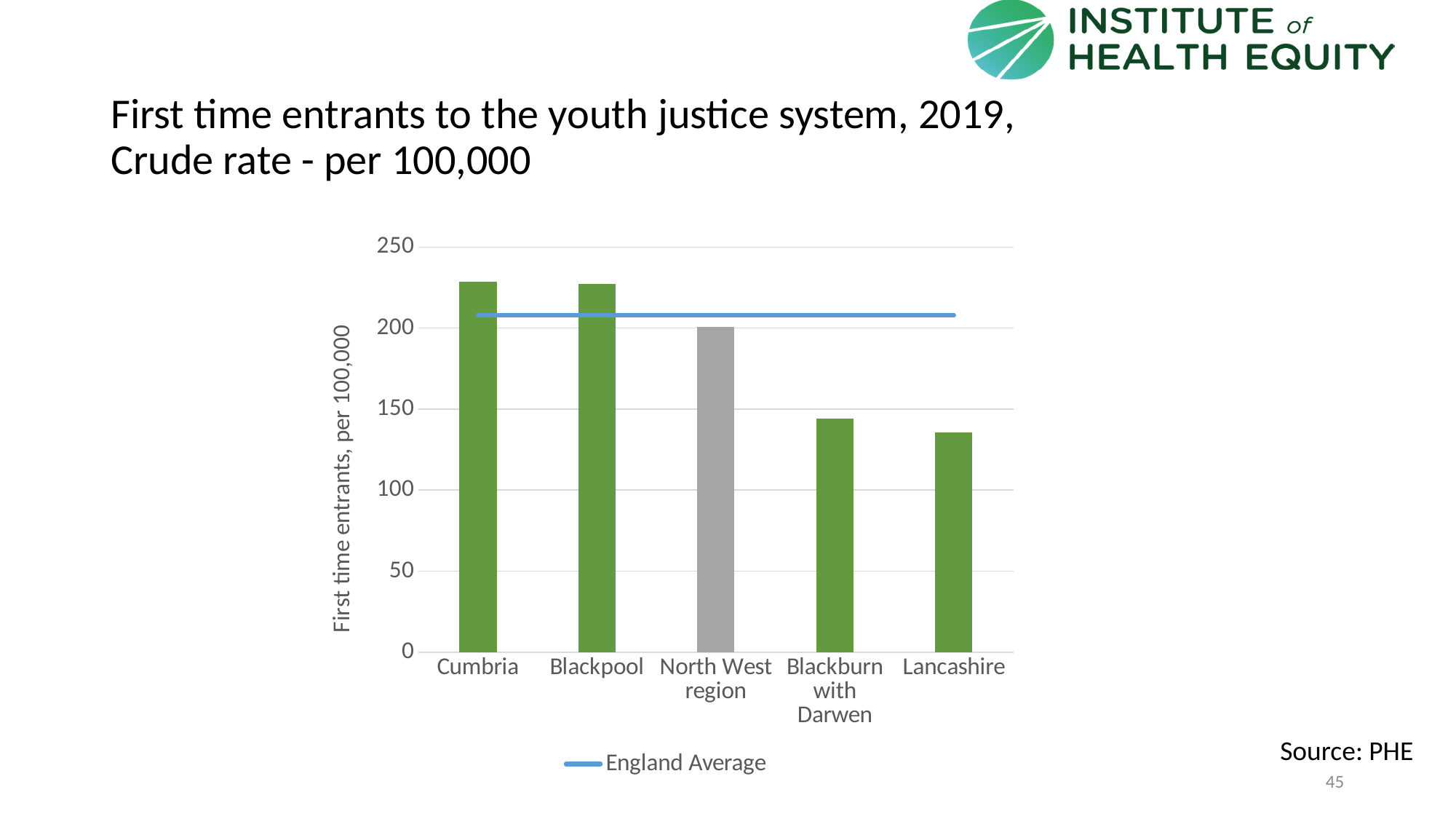
What kind of chart is shown on the slide? bar chart How many areas are shown on the x axis of the chart? 5 Do the bar values generally rise or fall moving from left to right along the x axis? fall Which is larger, the value for Blackpool or the value for Blackburn with Darwen? Blackpool Which is larger, the value for North West region or the value for Lancashire? North West region How many entries does the chart's legend list? 1 Is the value for Cumbria greater or less than 200? greater What does the blue horizontal line in the chart represent, according to the legend? England Average Is the value for Lancashire greater or less than 150? less Which area has the lowest rate of first time entrants in the chart? Lancashire Is the value for Blackburn with Darwen greater or less than 150? less